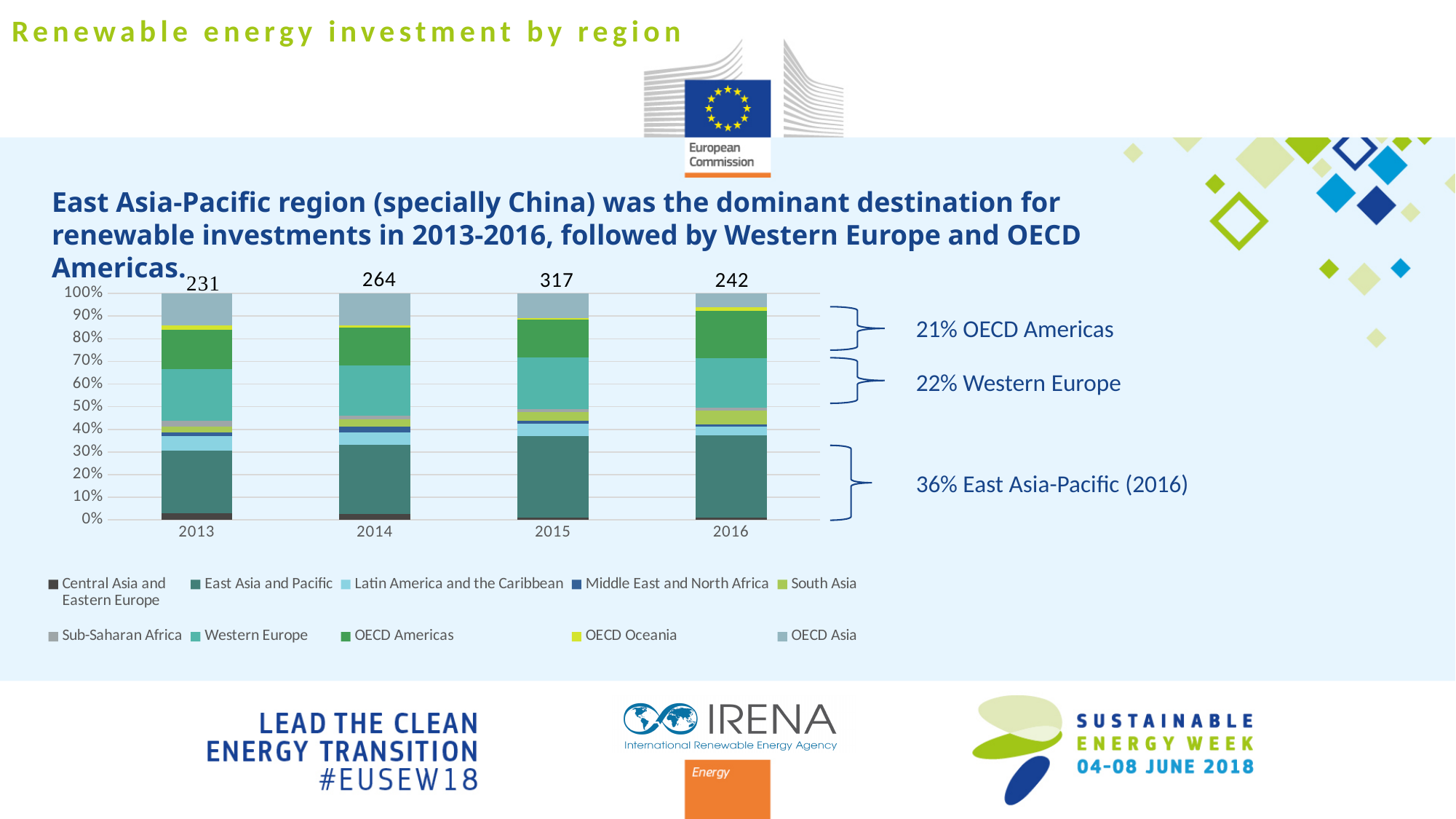
Is the East Asia and Pacific share in 2013 greater or less than 40%? less What is the difference between the totals printed above the 2015 and 2014 bars? 53 What kind of chart is shown on the slide? Stacked bar chart What is the title of the slide containing the chart? Renewable energy investment by region Which year has the larger total printed above its bar, 2014 or 2016? 2014 What total value is printed above the 2013 bar? 231 How many series does the legend list? 10 Which year has the highest total printed above its bar? 2015 According to the annotation, what share of investment went to East Asia-Pacific in 2016? 36% Which year has the lowest total printed above its bar? 2013 What total value is printed above the 2015 bar? 317 How many years (bars) are shown on the x axis? 4